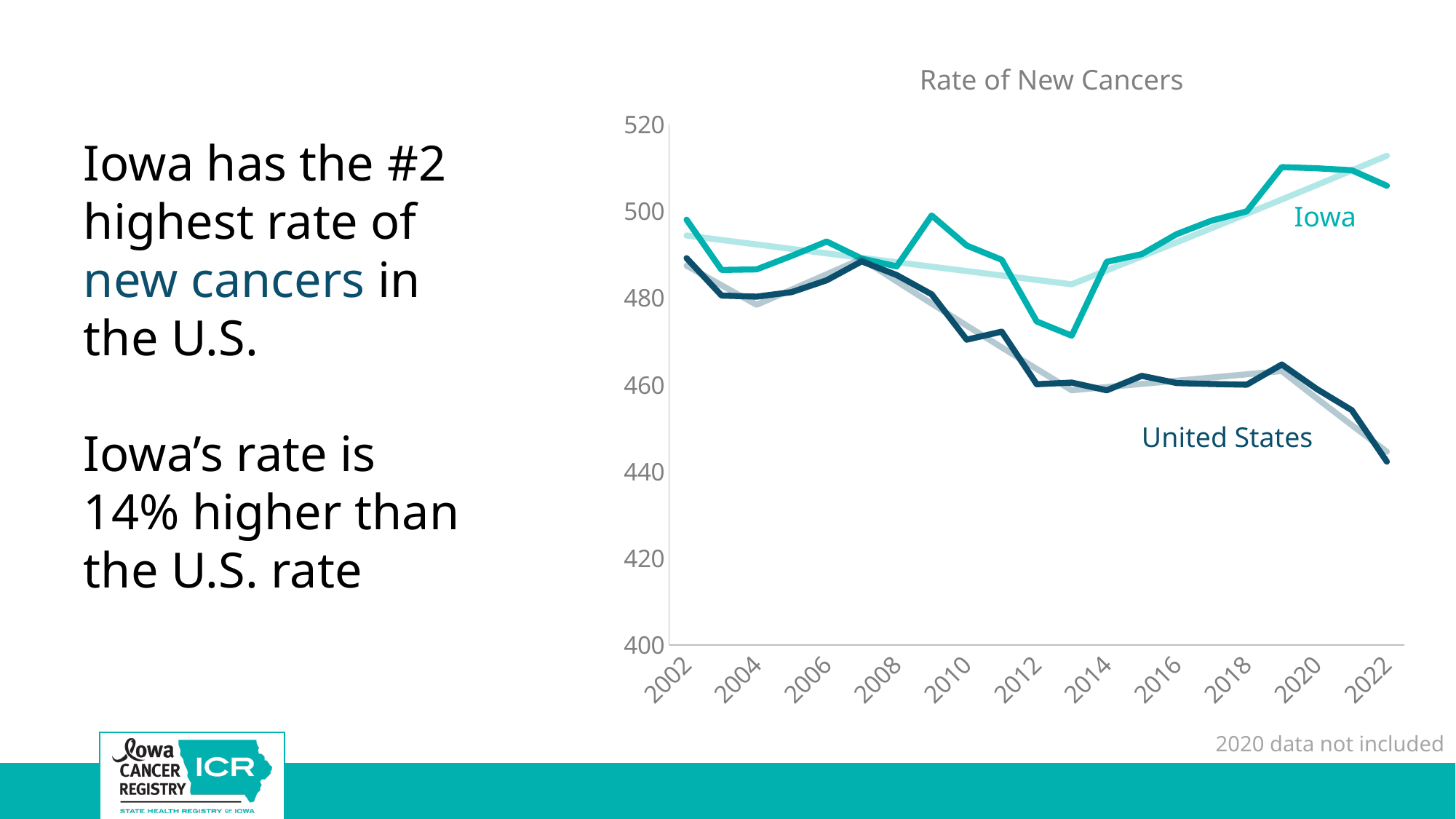
Is the United States value for 2022 greater or less than 460? less What kind of chart is shown on the slide? line chart Does the Iowa line rise or fall from 2013 to 2019? rise Which two series are labelled on the chart? Iowa and United States Is the United States value for 2002 greater or less than 480? greater How many data series are labelled on the chart? 2 In 2022, which series has the higher rate, Iowa or United States? Iowa Is the Iowa value for 2013 greater or less than 480? less Does the United States line rise or fall overall from 2002 to 2022? fall What is the title of the chart? Rate of New Cancers